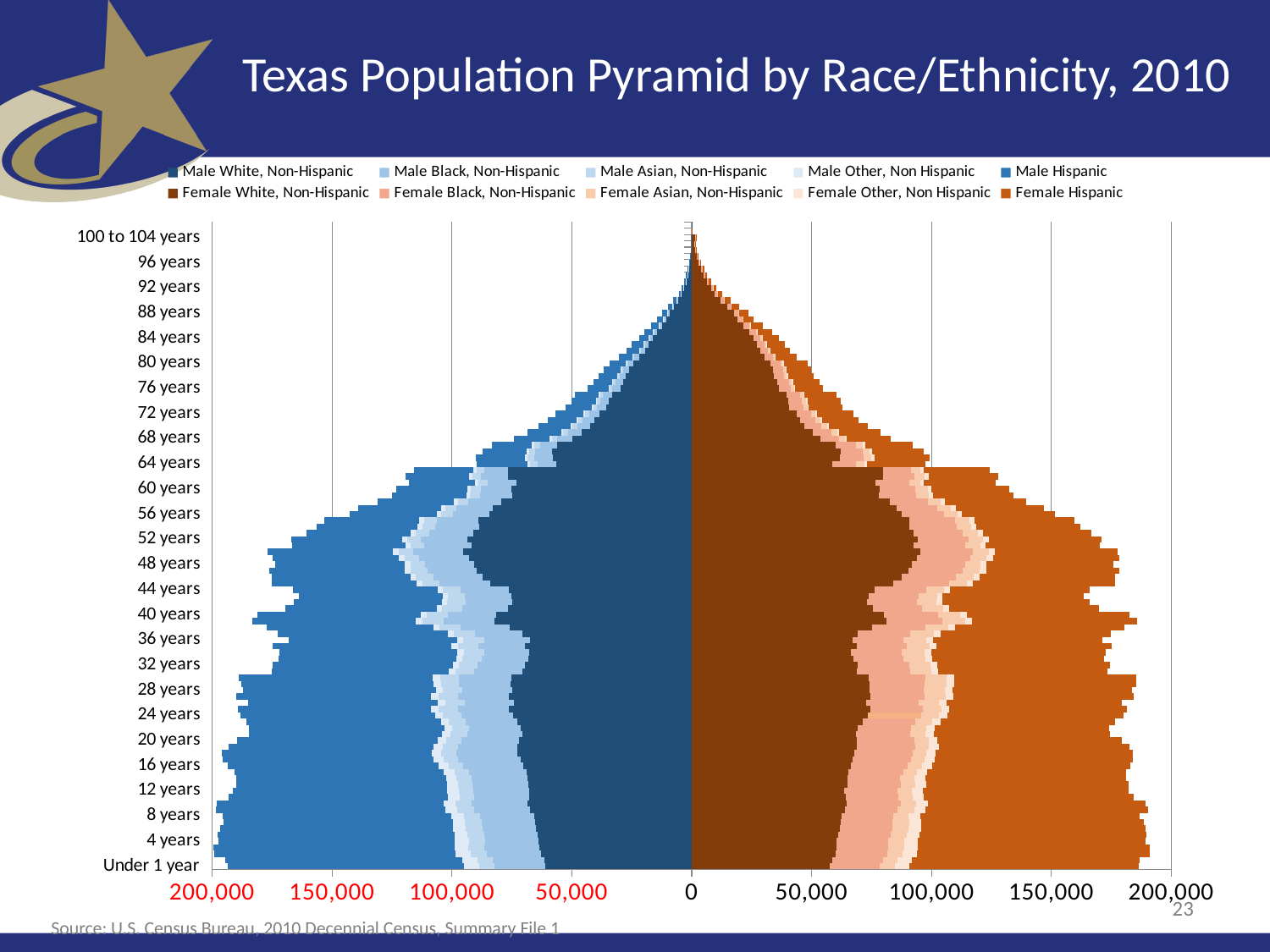
Is the total male bar for 60 years greater or less than 100,000? greater Which side of the chart, left or right, shows the male series? left What kind of chart is shown on the slide? bar chart Is the total male bar for 48 years greater or less than 150,000? greater How many series does the legend list? 10 Do the bars generally get longer or shorter as age increases from Under 1 year to 100 to 104 years? shorter Is the total male bar for 100 to 104 years greater or less than 50,000? less Which is larger, the total male bar for 48 years or the total male bar for 80 years? 48 years What is the title of the chart? Texas Population Pyramid by Race/Ethnicity, 2010